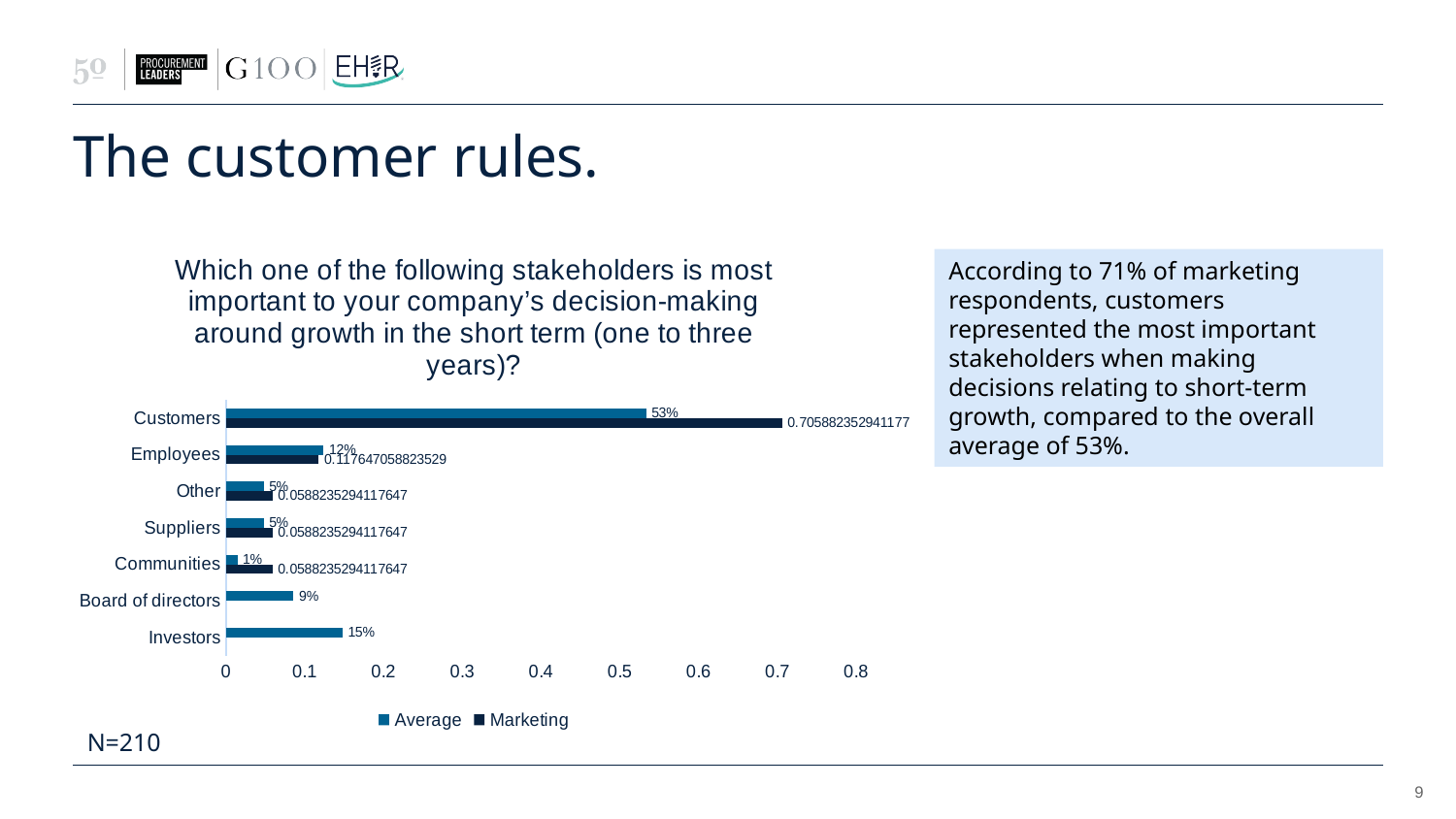
How many stakeholder categories are plotted on the chart? 7 What is the Average value for Board of directors? 9% Which category has the lowest Average value? Communities What is the Average value for Customers? 53% What is the Average value for Investors? 15% What is the difference between the Average values for Customers and Employees? 41% Which has the larger Average value, Investors or Employees? Investors Which category has the highest Average value? Customers What is the Marketing value for Customers? 0.705882352941177 Is the Marketing value for Customers greater or less than 0.6? greater How many series does the chart's legend list? 2 What kind of chart is shown on the slide? bar chart